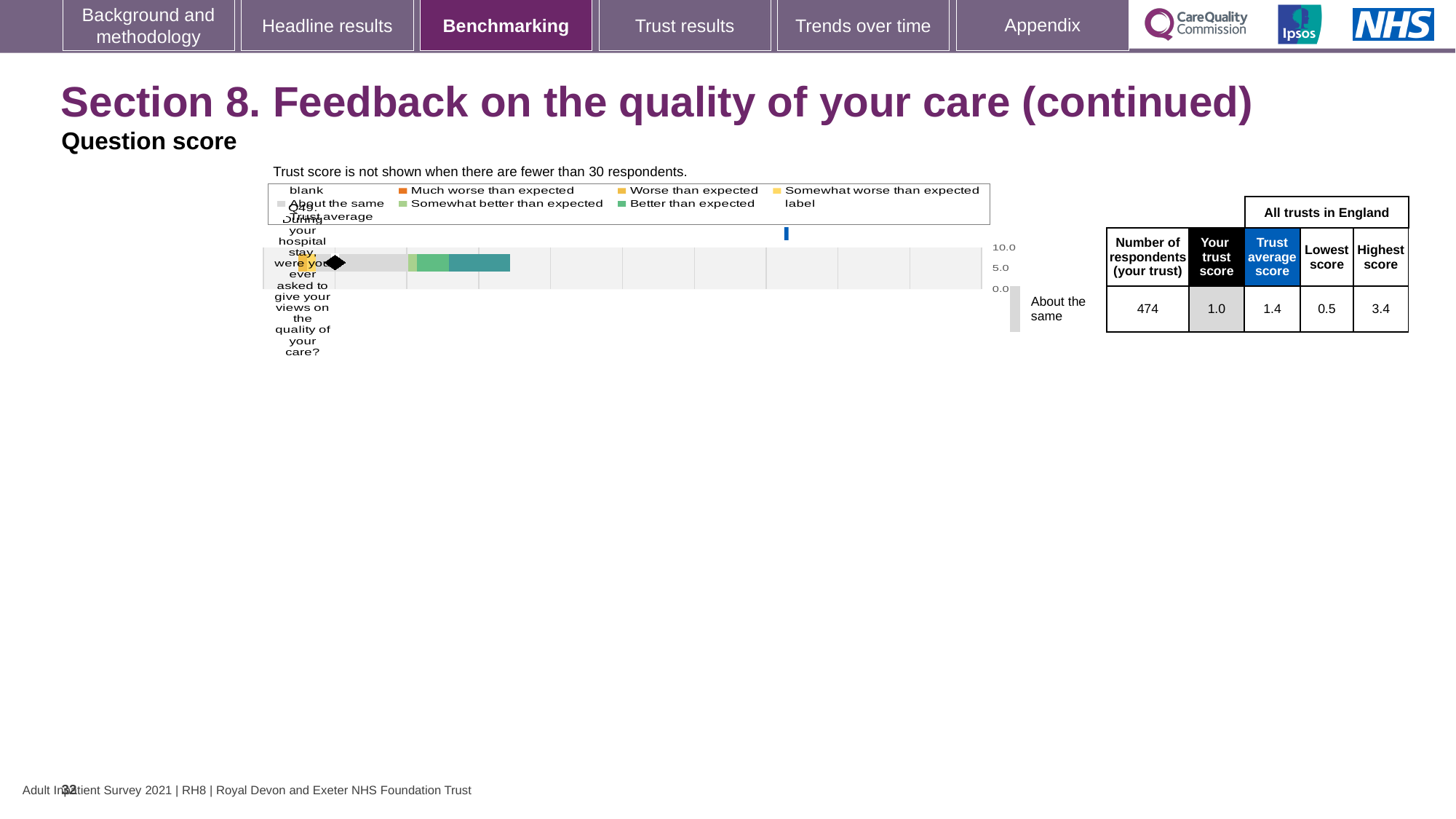
What is the difference between the trust average score and the trust's score for Q49? 0.4 Which legend entry is shown in orange? Much worse than expected What is the trust's score for Q49 shown next to the chart? 1.0 Which benchmark category is the trust's Q49 result placed in? About the same What kind of chart is used to show the Q49 benchmarking result? bar chart How many survey questions are plotted in the chart? 1 What is the highest score across all trusts in England for Q49? 3.4 What is the difference between the highest and lowest scores across all trusts for Q49? 2.9 What is the trust average score for Q49? 1.4 How many respondents from the trust answered Q49? 474 What is the lowest score across all trusts in England for Q49? 0.5 Which is larger for Q49, the trust's score or the trust average score? Trust average score